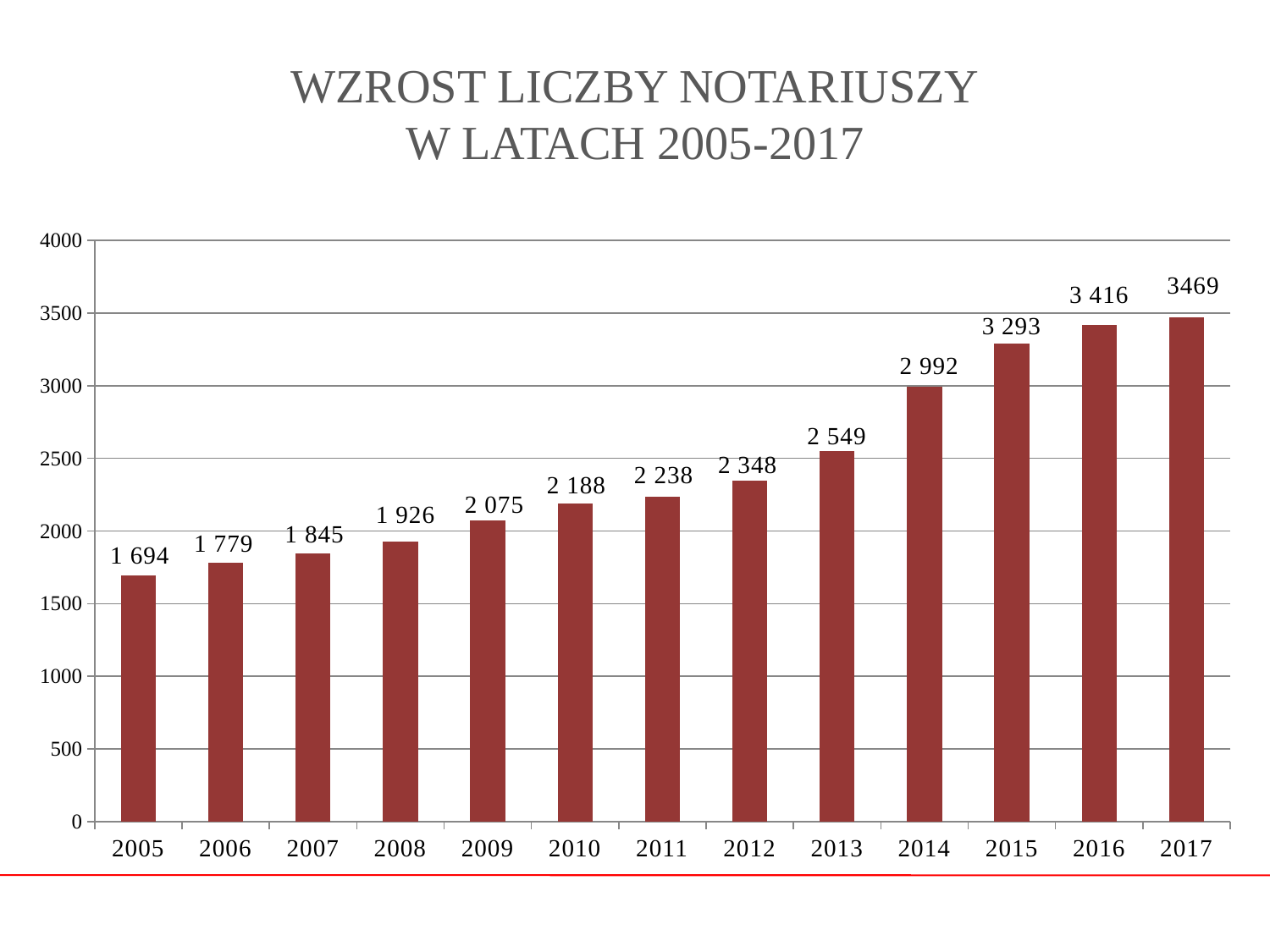
What kind of chart is shown on the slide? bar chart What is the value for 2013? 2 549 Do the values rise or fall from 2005 to 2017? rise Is the value for 2014 greater or less than 2500? greater Which year has the highest value? 2017 What is the difference between the values for 2017 and 2005? 1775 Which year has the lowest value? 2005 What is the value for 2017? 3469 Which is larger, the value for 2010 or the value for 2012? 2012 How many years are shown on the x axis? 13 What is the value for 2005? 1 694 What is the difference between the values for 2014 and 2013? 443